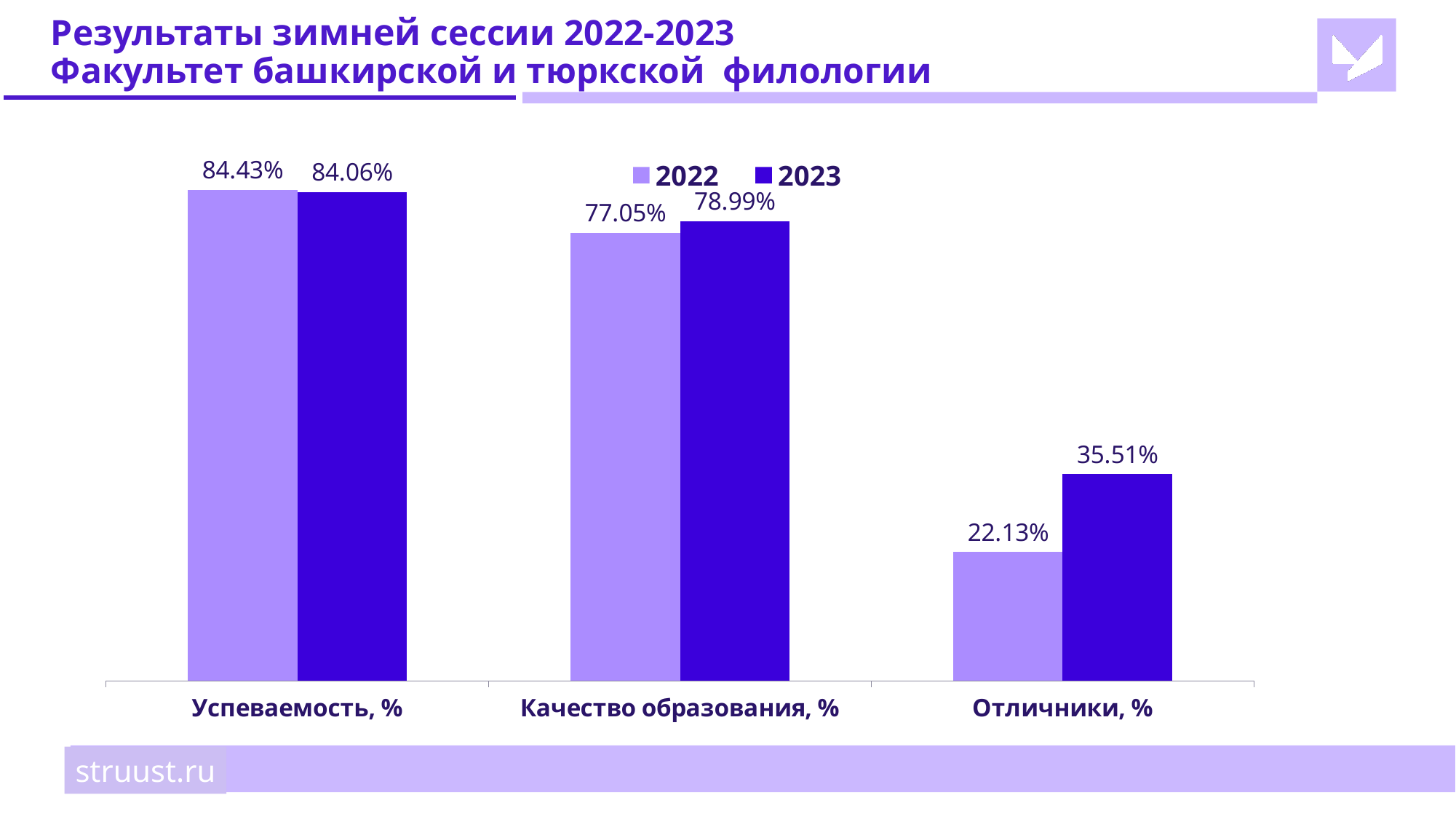
What is the difference between the 2023 and 2022 values for Отличники, %? 13.38% What is the value for Успеваемость, % in 2022? 84.43% Which category has the highest value for 2022? Успеваемость, % How many series does the legend list? 2 What type of chart is shown on the slide? bar chart For Качество образования, %, which year has the larger value, 2022 or 2023? 2023 Which category has the lowest value for 2023? Отличники, % What is the value for Качество образования, % in 2023? 78.99% Which series does the lighter purple colour represent in the legend? 2022 What is the value for Отличники, % in 2022? 22.13% What is the value for Успеваемость, % in 2023? 84.06% How many categories are shown on the x axis? 3